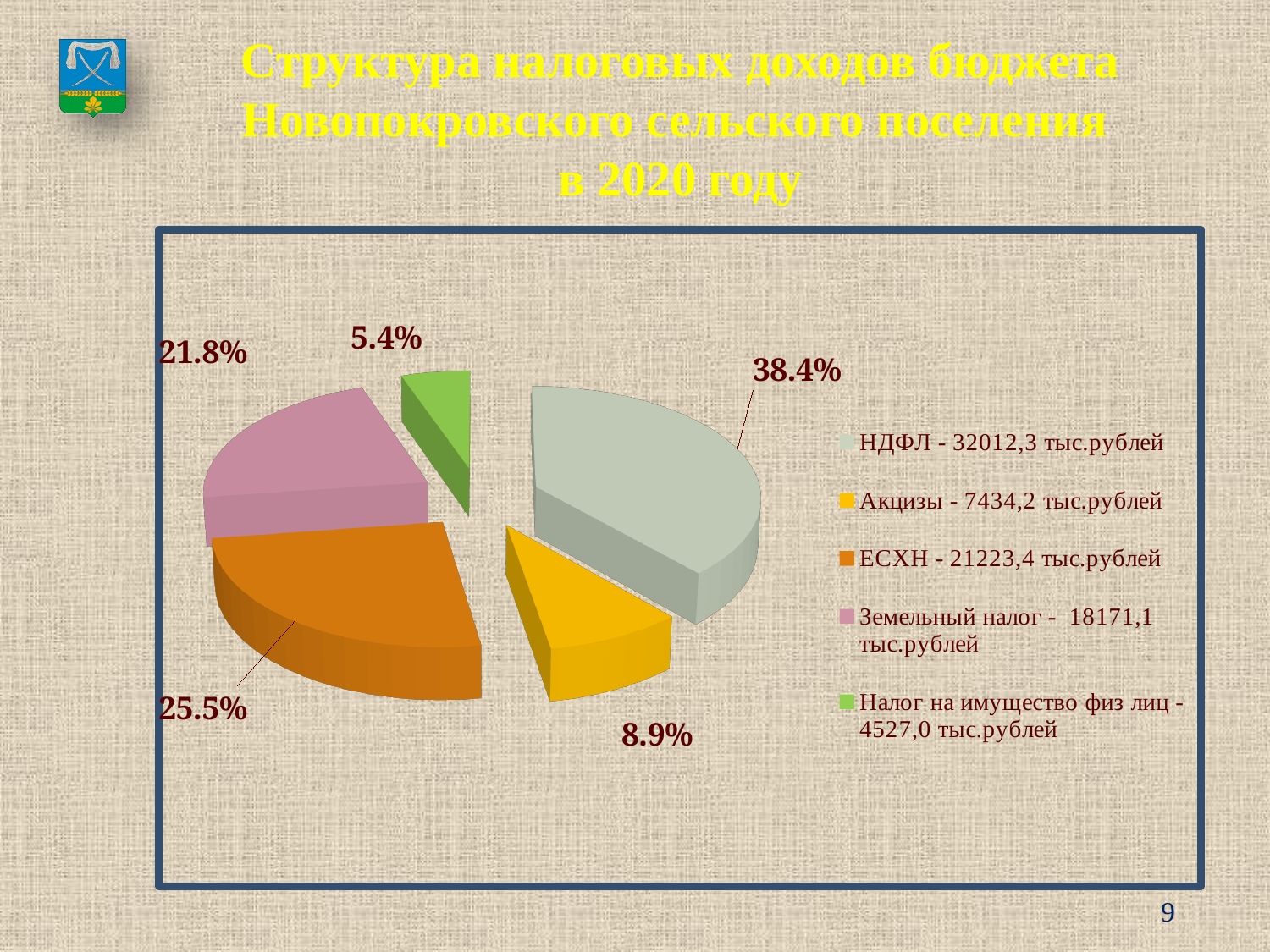
What is the difference in percentage points between the НДФЛ slice and the ЕСХН slice? 12.9 What share of the pie does Земельный налог account for? 21.8% According to the legend, what amount in тыс.рублей is given for ЕСХН? 21223,4 тыс.рублей Which category has the largest slice of the pie? НДФЛ Which category has the smallest slice of the pie? Налог на имущество физ лиц What share of the pie does Налог на имущество физ лиц account for? 5.4% How many slices does the pie chart have? 5 What share of the pie does НДФЛ account for? 38.4% Which is larger, the share for Земельный налог or the share for Акцизы? Земельный налог What kind of chart is shown on the slide? Pie chart